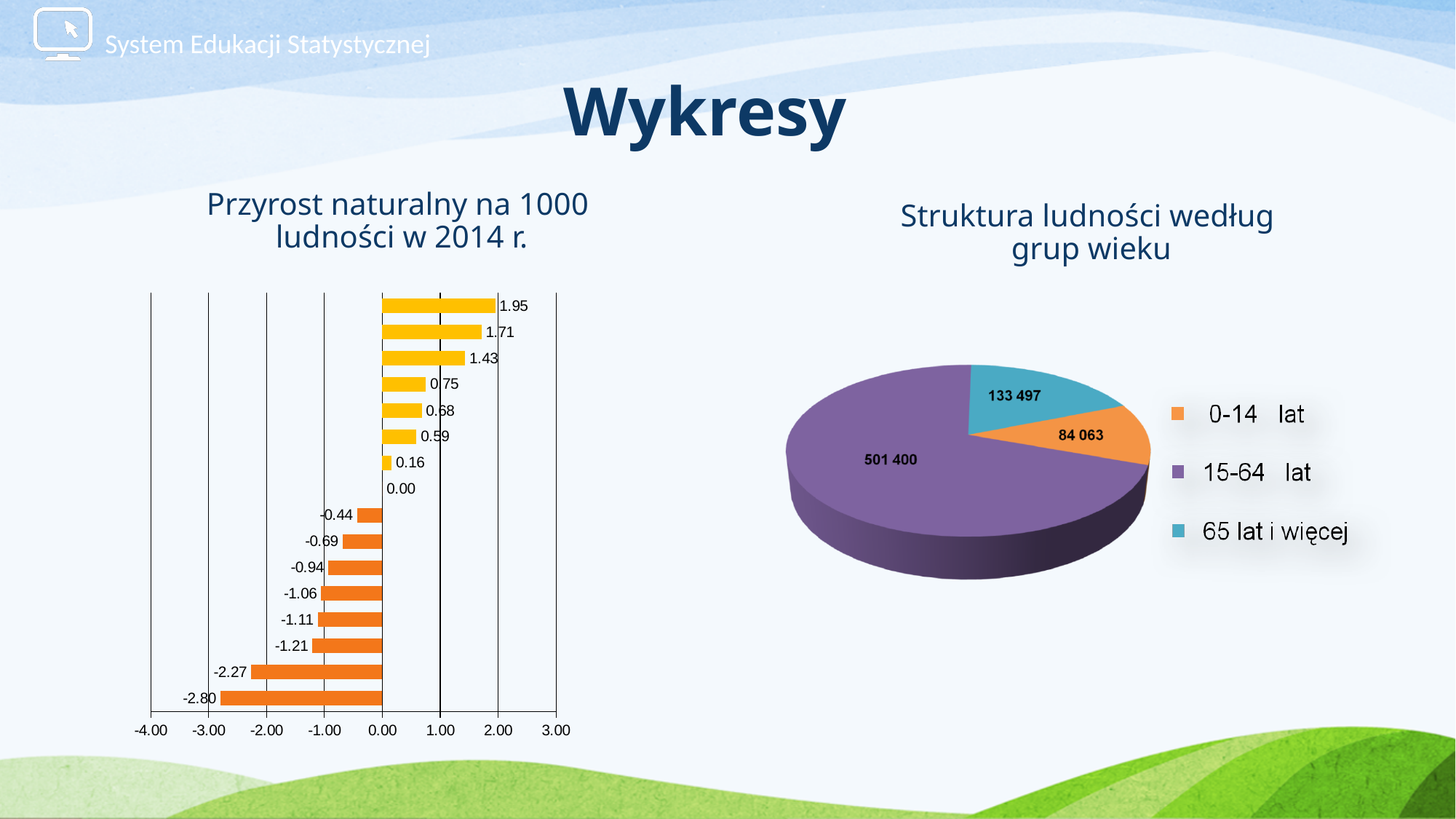
In the chart "Struktura ludności według grup wieku", which age group has the smallest slice? 0-14 lat In the chart "Przyrost naturalny na 1000 ludności w 2014 r.", how many bars are plotted? 16 What kind of chart is the one titled "Przyrost naturalny na 1000 ludności w 2014 r."? bar chart In the chart "Struktura ludności według grup wieku", how many entries does the legend list? 3 In the chart "Przyrost naturalny na 1000 ludności w 2014 r.", what is the highest value shown? 1.95 In the chart "Struktura ludności według grup wieku", how much larger is the 65 lat i więcej value than the 0-14 lat value? 49 434 In the chart "Przyrost naturalny na 1000 ludności w 2014 r.", what is the lowest value shown? -2.80 In the chart "Struktura ludności według grup wieku", what is the value for the 15-64 lat group? 501 400 What kind of chart is the one titled "Struktura ludności według grup wieku"? pie chart In the chart "Przyrost naturalny na 1000 ludności w 2014 r.", what is the difference between the highest value (1.95) and the lowest value (-2.80)? 4.75 In the chart "Struktura ludności według grup wieku", what is the value for the 0-14 lat group? 84 063 In the chart "Struktura ludności według grup wieku", what is the value for the 65 lat i więcej group? 133 497